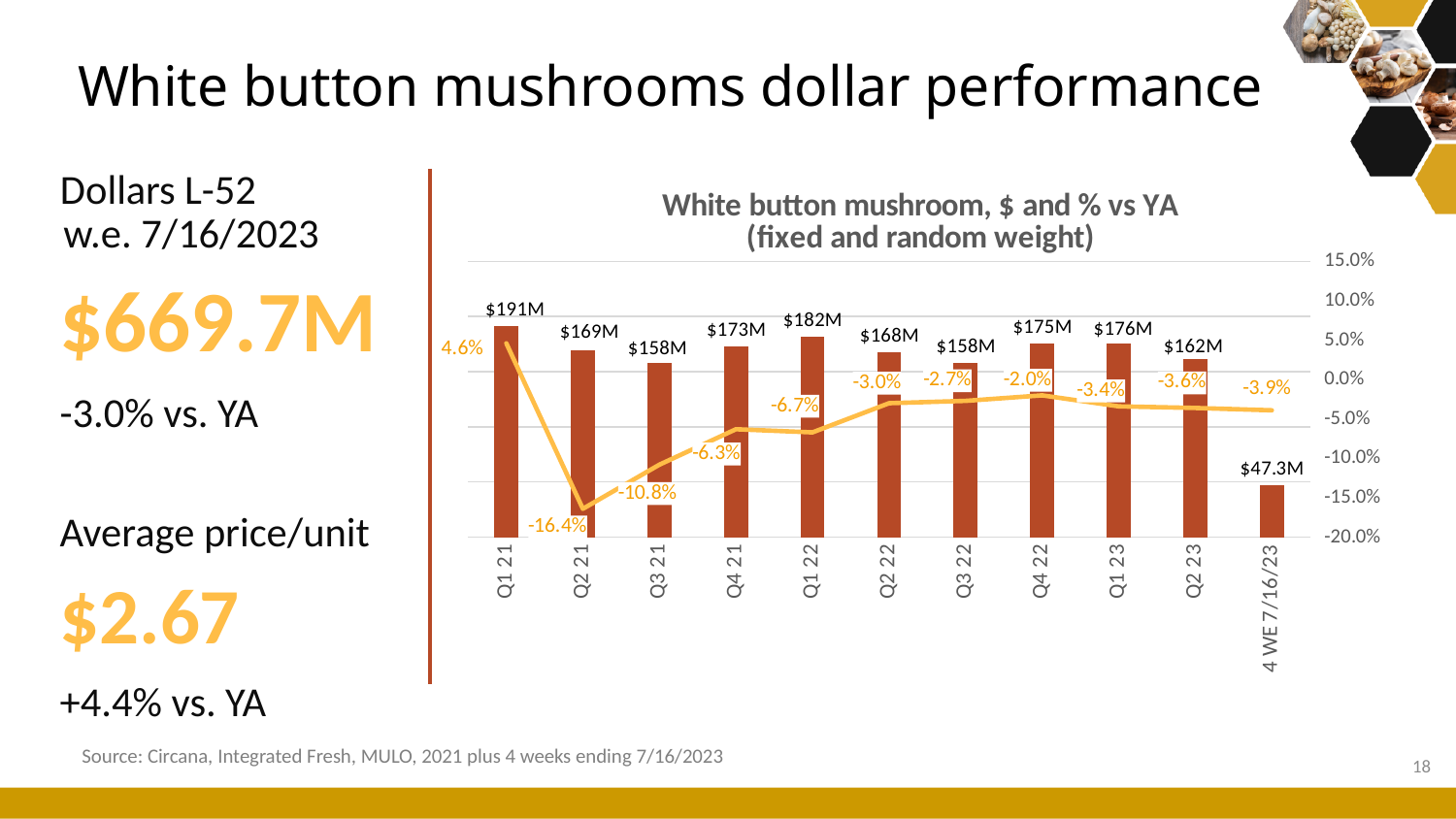
What is the % vs YA value shown for Q2 21? -16.4% What is the % vs YA value shown for Q4 22? -2.0% Does the % vs YA line rise or fall from Q2 21 to Q4 22? Rise How many periods are shown on the x axis of the chart? 11 Which period has the lowest % vs YA value on the line? Q2 21 What kind of chart is shown on the slide? Combination bar and line chart What is the title of the chart? White button mushroom, $ and % vs YA (fixed and random weight) What is the dollar value shown for the 4 WE 7/16/23 period? $47.3M Which quarter has the highest dollar value among the bars? Q1 21 Which has a larger dollar value, Q4 22 or Q1 23? Q1 23 What is the difference in dollar value between Q1 22 and Q2 22? $14M What is the dollar value shown for Q1 21? $191M